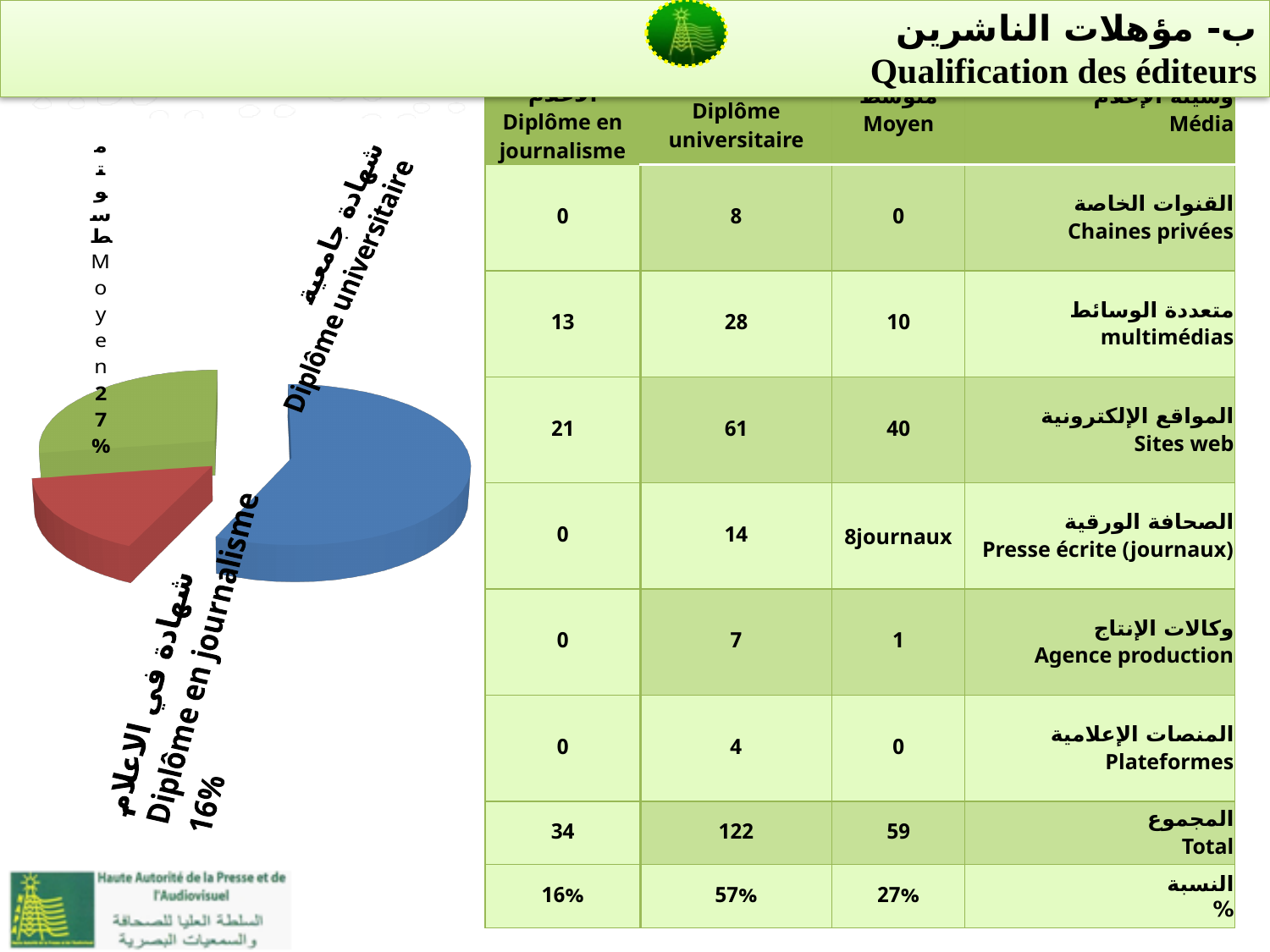
What share of the pie chart is labelled for Moyen? 27% Which category has the largest slice in the pie chart? Diplôme universitaire What share of the pie chart is labelled for Diplôme en journalisme? 16% What kind of chart is shown on the left of the slide? pie chart In the pie chart, which is larger: the Moyen slice or the Diplôme en journalisme slice? Moyen What colour is the Moyen slice in the pie chart? green According to the table on the slide, what percentage corresponds to Diplôme universitaire? 57% How many slices does the pie chart have? 3 What is the difference in percentage points between the Moyen slice and the Diplôme en journalisme slice? 11% What colour is the Diplôme universitaire slice in the pie chart? blue Which category has the smallest slice in the pie chart? Diplôme en journalisme